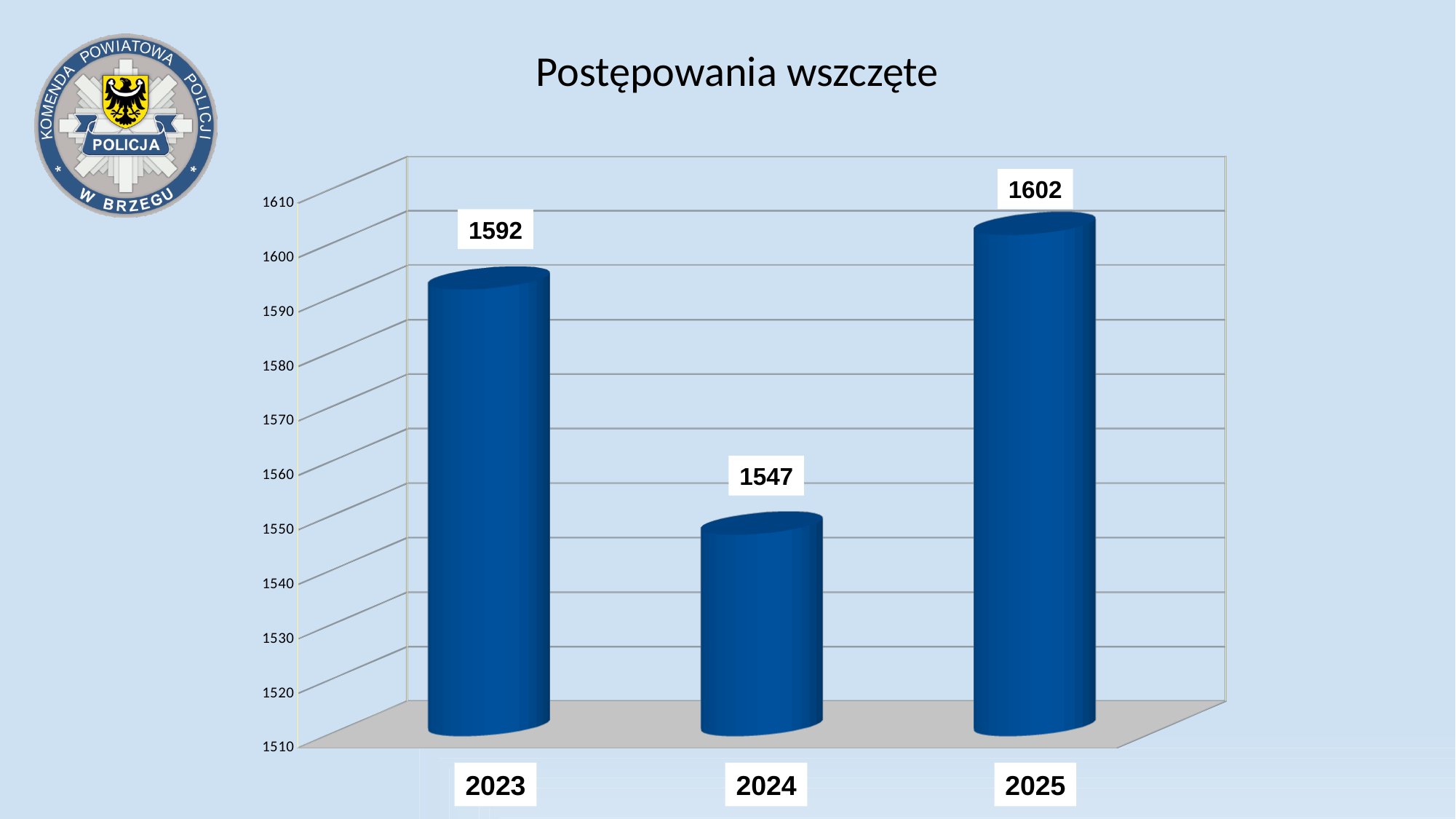
What is the value for 2025? 1602 Is the value for 2024 greater or less than 1560? less Which is larger, the value for 2023 or the value for 2025? 2025 What is the value for 2024? 1547 What is the difference between the values for 2023 and 2024? 45 What is the value for 2023? 1592 What is the difference between the values for 2025 and 2024? 55 What kind of chart is shown on the slide? bar chart Which year has the lowest value? 2024 Which year has the highest value? 2025 How many years are shown on the chart? 3 What is the title of the chart? Postępowania wszczęte